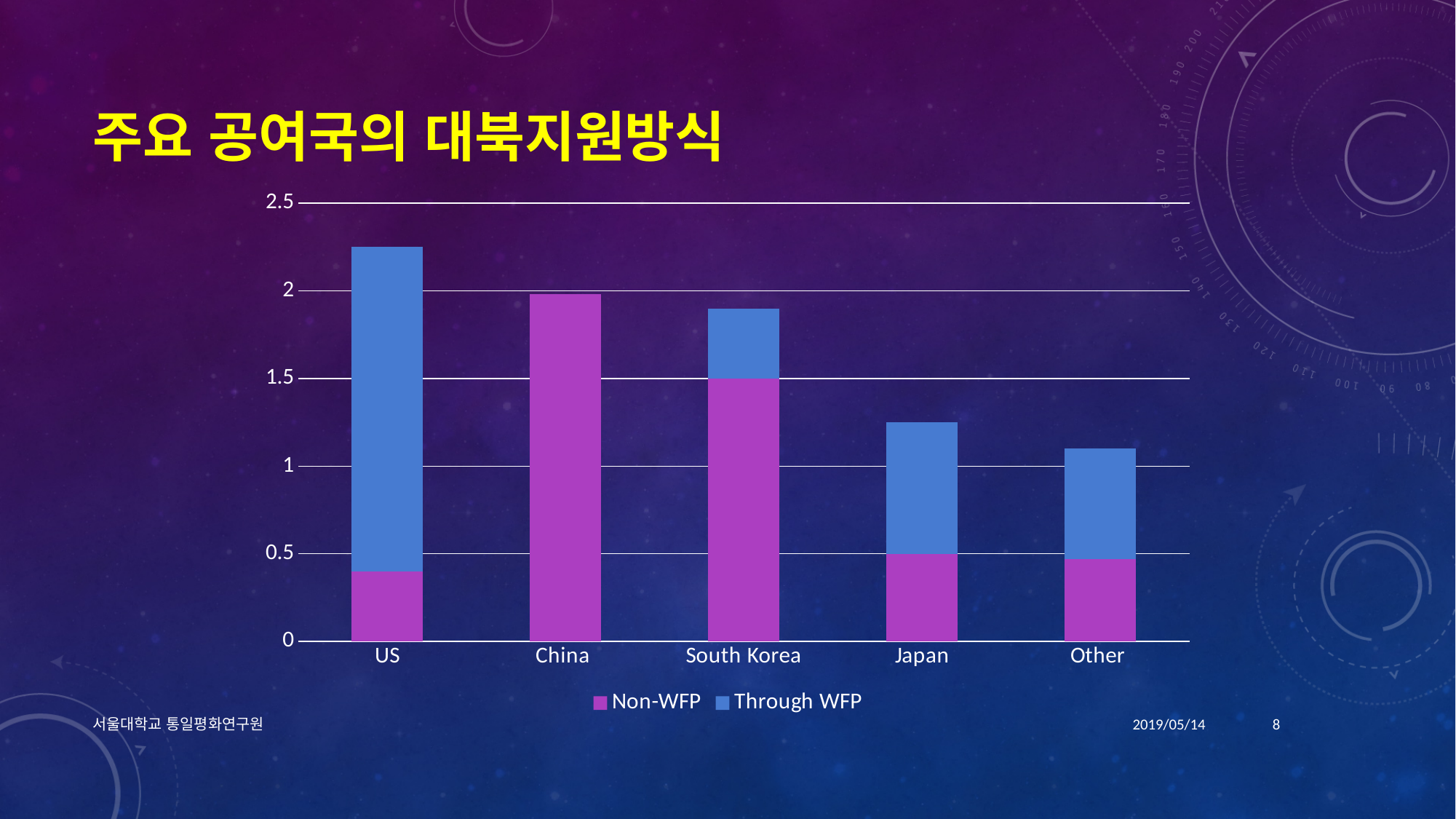
Is the Non-WFP value for US greater or less than 0.5? less How many series does the legend list? 2 Which category has the lowest total bar? Other Is the total value for Japan greater or less than 1? greater What kind of chart is shown on the slide? stacked bar chart Which category has the largest Non-WFP segment? China Is the total value for US greater or less than 2? greater Which category has the largest Through WFP segment? US Which has the larger total bar, Japan or Other? Japan Which category has the highest total bar? US How many countries/categories are shown on the x axis? 5